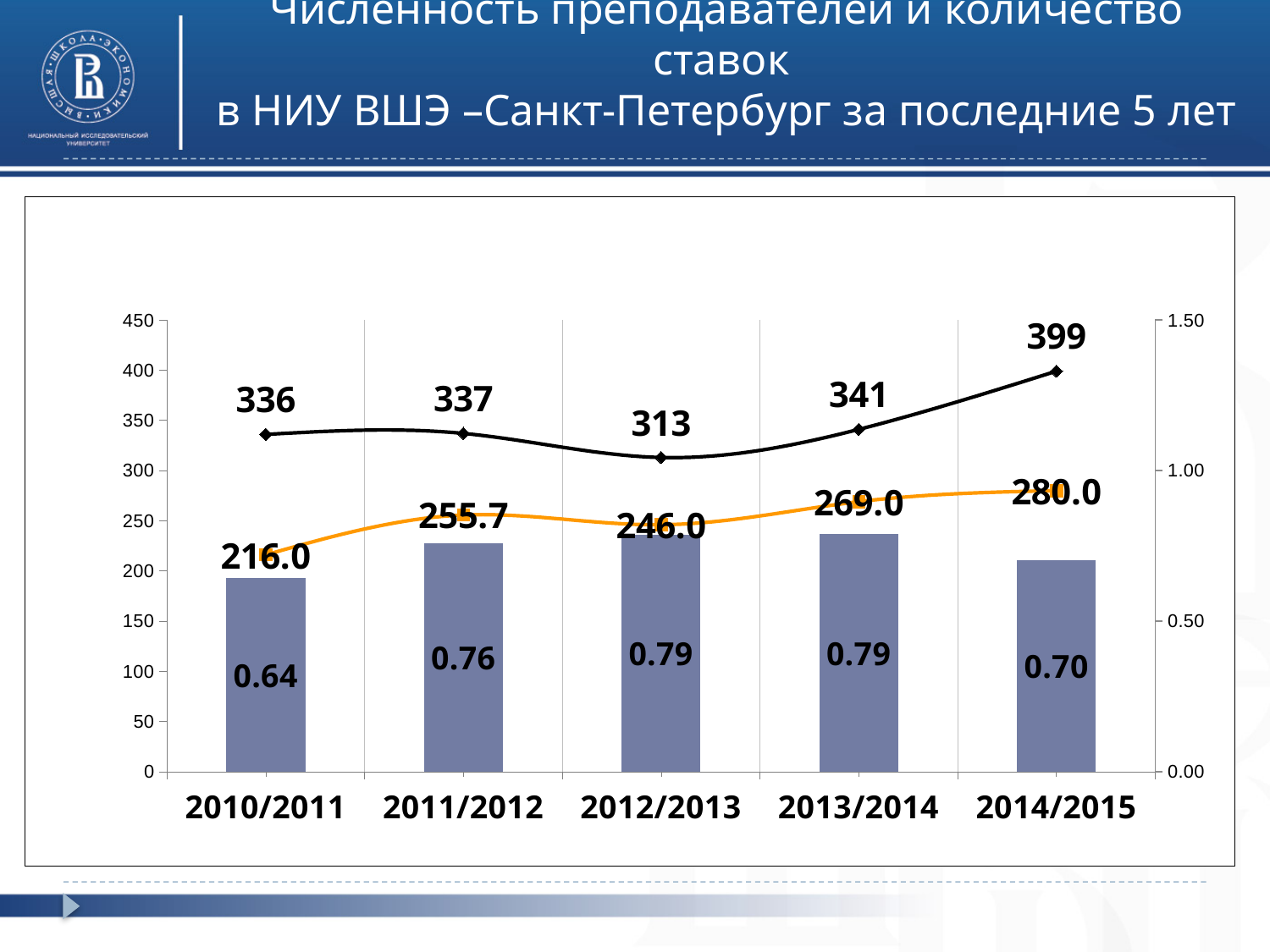
What is the difference between the black line values for 2014/2015 and 2013/2014? 58 What is the maximum value shown on the right-hand axis? 1.50 Which is larger, the orange line value for 2011/2012 or for 2012/2013? 2011/2012 What value does the black line show for 2014/2015? 399 In which academic year does the black line have its lowest value? 2012/2013 In which academic year does the black line reach its highest value? 2014/2015 What value does the orange line show for 2011/2012? 255.7 Which academic year has the lowest bar value? 2010/2011 How many academic years are shown on the x axis? 5 What is the difference between the orange line values for 2014/2015 and 2010/2011? 64.0 Does the orange line generally rise or fall from 2010/2011 to 2014/2015? rise What value is labelled on the bar for 2010/2011? 0.64